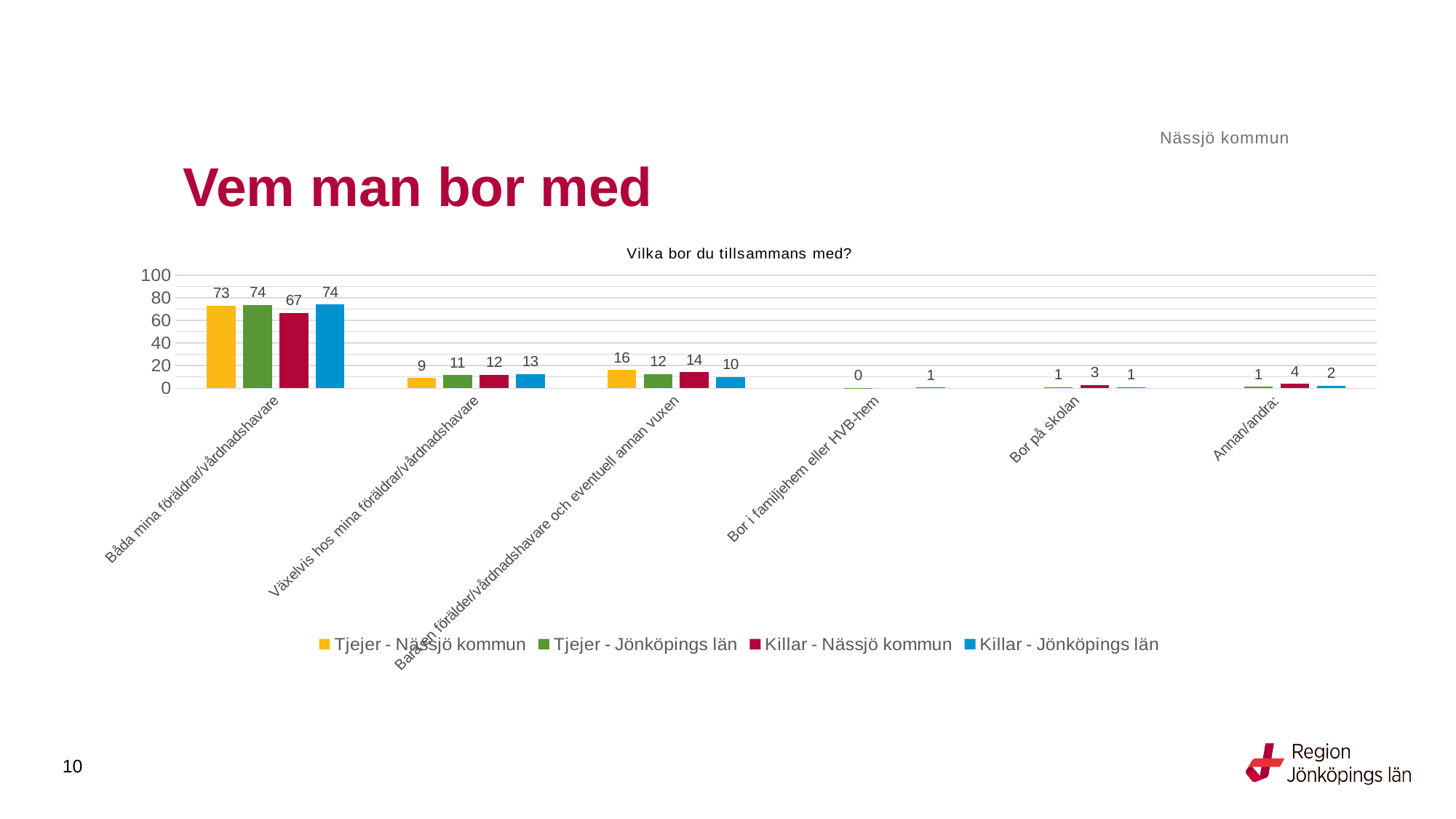
What is the value for Killar - Jönköpings län in the category 'Växelvis hos mina föräldrar/vårdnadshavare'? 13 Which series has the highest value in the category 'Bara en förälder/vårdnadshavare och eventuell annan vuxen'? Tjejer - Nässjö kommun How many series does the legend list? 4 What is the value for Tjejer - Nässjö kommun in the category 'Båda mina föräldrar/vårdnadshavare'? 73 In the category 'Växelvis hos mina föräldrar/vårdnadshavare', which is larger: Tjejer - Nässjö kommun or Killar - Jönköpings län? Killar - Jönköpings län How many categories are shown on the x axis of the chart? 6 Which series has the lowest value in the category 'Båda mina föräldrar/vårdnadshavare'? Killar - Nässjö kommun What is the value for Killar - Nässjö kommun in the category 'Annan/andra'? 4 What is the value for Killar - Nässjö kommun in the category 'Båda mina föräldrar/vårdnadshavare'? 67 In the category 'Båda mina föräldrar/vårdnadshavare', what is the difference between Tjejer - Jönköpings län and Killar - Nässjö kommun? 7 What is the title of the chart? Vilka bor du tillsammans med? What is the value for Tjejer - Nässjö kommun in the category 'Bara en förälder/vårdnadshavare och eventuell annan vuxen'? 16